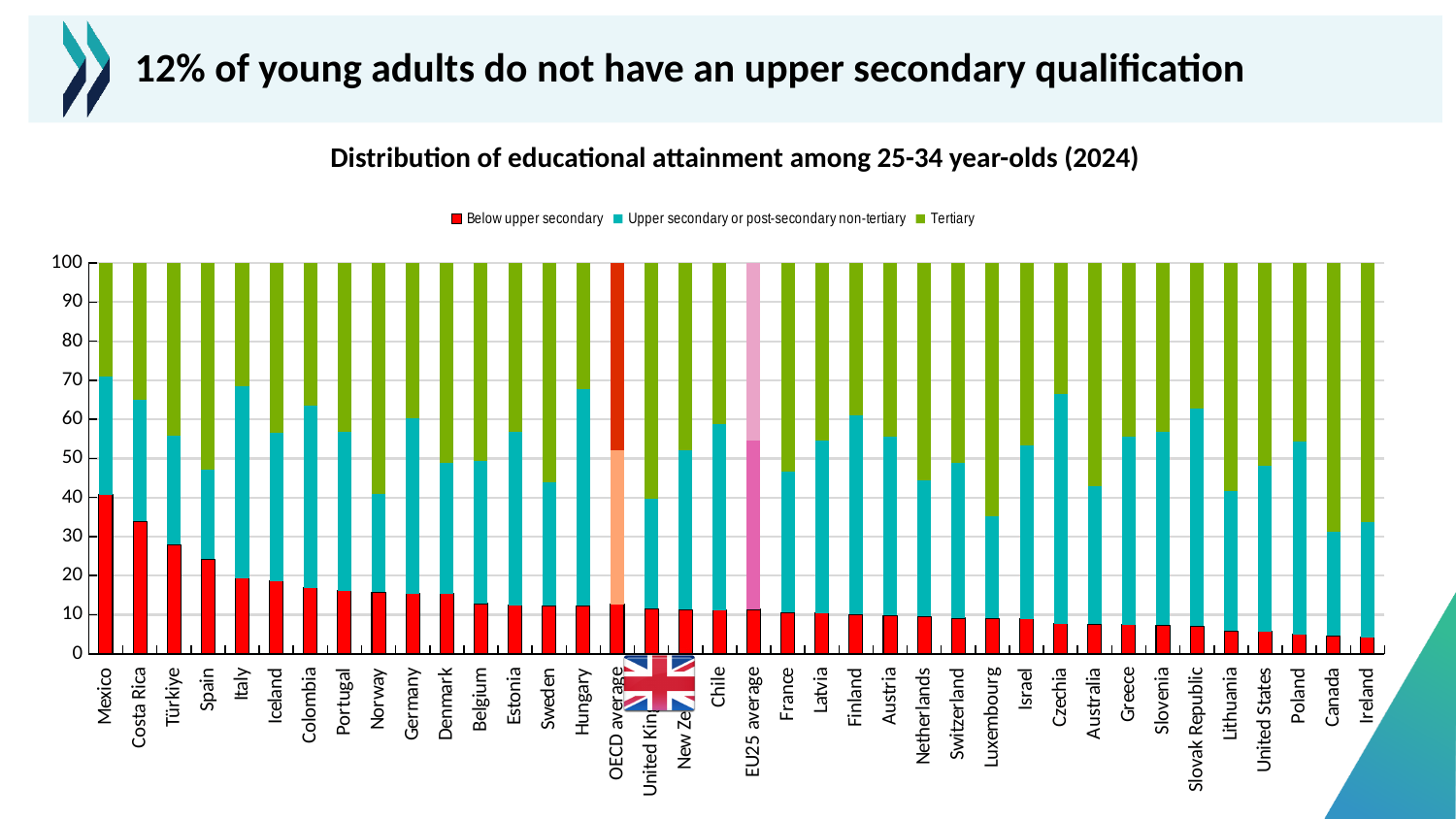
Is the 'Below upper secondary' value for Ireland greater or less than 10? less Which colour represents the 'Tertiary' series in the legend? Green Do the 'Below upper secondary' values rise or fall moving from left to right along the x axis? Fall Which has a larger 'Below upper secondary' share, Mexico or Costa Rica? Mexico How many series does the legend list? 3 Is the 'Below upper secondary' value for Mexico greater or less than 30? greater Is the 'Below upper secondary' value for Spain greater or less than 20? greater Which country has the highest share of 'Below upper secondary'? Mexico What is the title of the chart? Distribution of educational attainment among 25-34 year-olds (2024) What kind of chart is shown on the slide? Stacked bar chart What is the total of the stacked bar for Mexico? 100